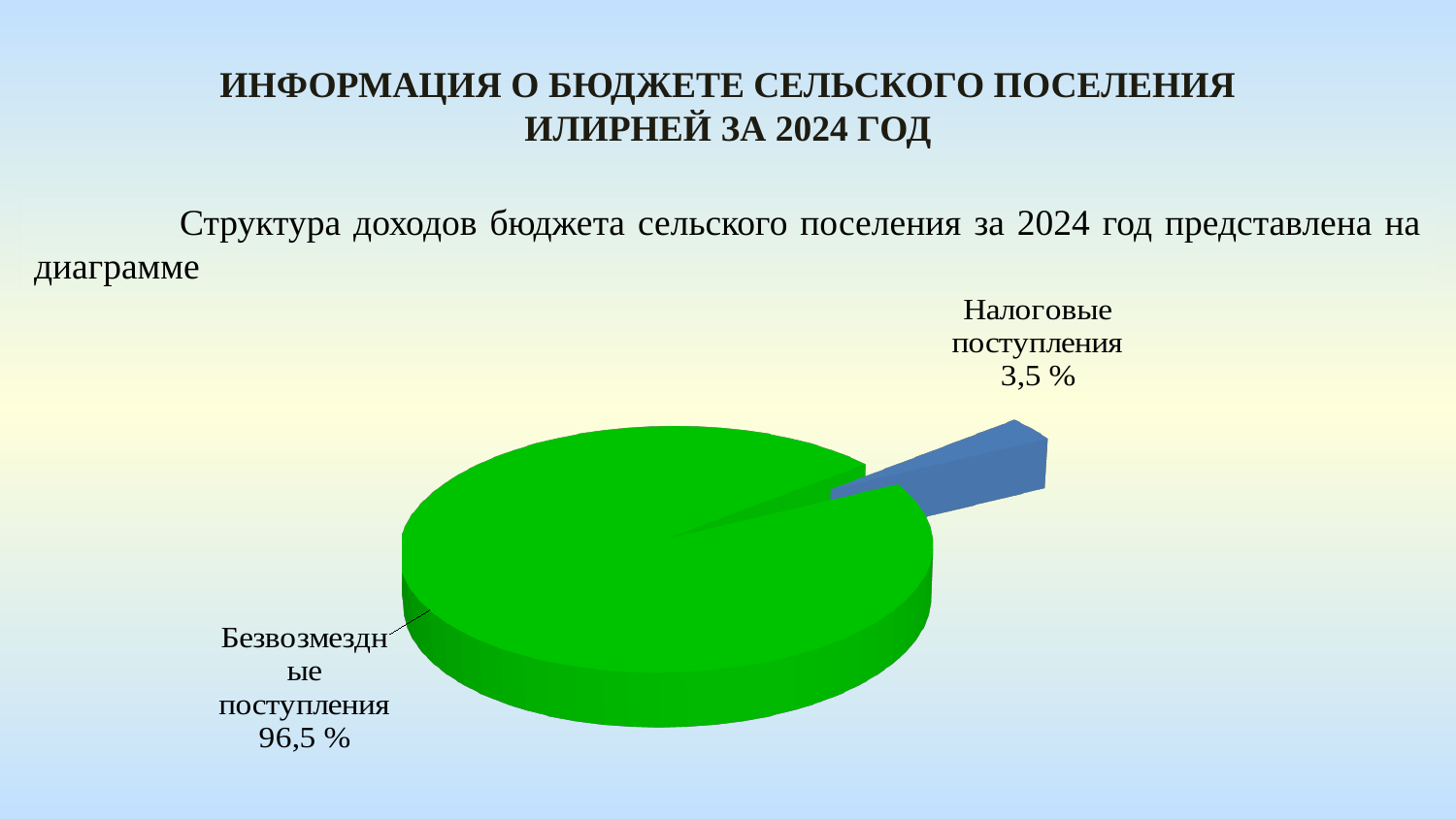
Is the share for "Налоговые поступления" greater or less than 10 %? less What is the difference in percentage points between "Безвозмездные поступления" and "Налоговые поступления"? 93 percentage points Which is larger: "Налоговые поступления" or "Безвозмездные поступления"? Безвозмездные поступления Is the share for "Безвозмездные поступления" greater or less than 90 %? greater What colour is the slice for "Безвозмездные поступления"? Green How many slices does the pie chart have? 2 What share of the pie is labelled "Безвозмездные поступления"? 96,5 % What colour is the slice for "Налоговые поступления"? Blue What share of the pie is labelled "Налоговые поступления"? 3,5 % What kind of chart is shown on the slide? Pie chart Which slice of the pie is the largest? Безвозмездные поступления Which slice of the pie is the smallest? Налоговые поступления